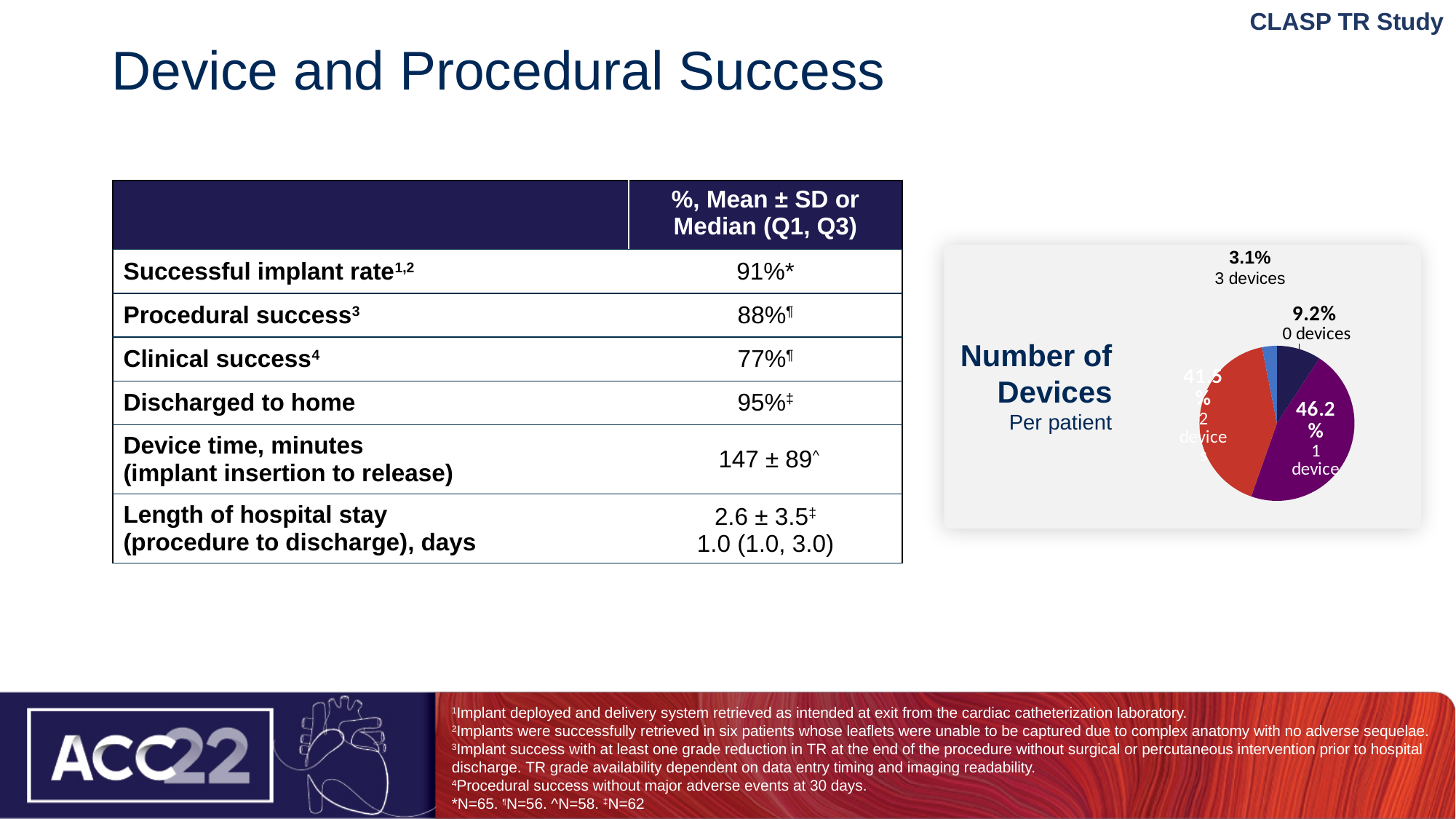
What percentage of patients received 2 devices? 41.5% What is the difference in percentage points between the 1 device share and the 2 devices share? 4.7 Which number of devices per patient has the smallest share of the pie? 3 devices What percentage of patients received 3 devices? 3.1% What is the title of the pie chart? Number of Devices Per patient What colour is the slice for 1 device? purple How many slices does the pie chart have? 4 What percentage of patients received 0 devices? 9.2% What kind of chart is shown on the slide? pie chart Which number of devices per patient has the largest share of the pie? 1 device Which share is larger: 1 device or 2 devices? 1 device What percentage of patients received 1 device? 46.2%